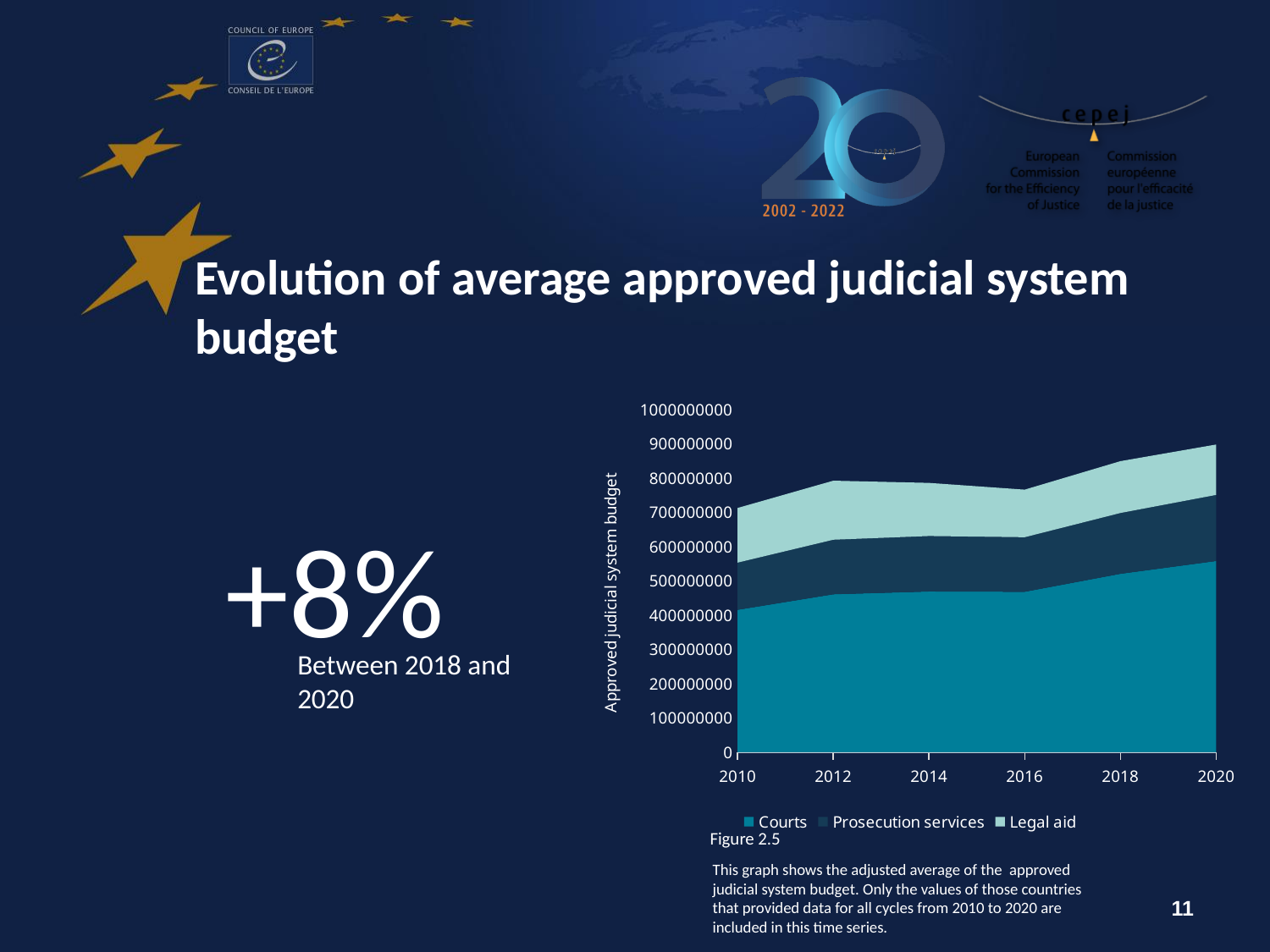
Does the total approved judicial system budget rise or fall between 2016 and 2020? rise How many year labels are shown along the x axis of the chart? 6 Is the value for Courts in 2020 greater or less than 500000000? greater Is the total approved judicial system budget in 2010 greater or less than 800000000? less Is the total approved judicial system budget in 2020 greater or less than 800000000? greater How many series does the chart's legend list? 3 Which series are listed in the chart's legend? Courts, Prosecution services, Legal aid In 2020, which is larger: the value for Courts or the value for Legal aid? Courts What kind of chart is shown on the slide? area chart What is the label of the chart's vertical axis? Approved judicial system budget Which series occupies the largest part of the stacked area in 2020? Courts